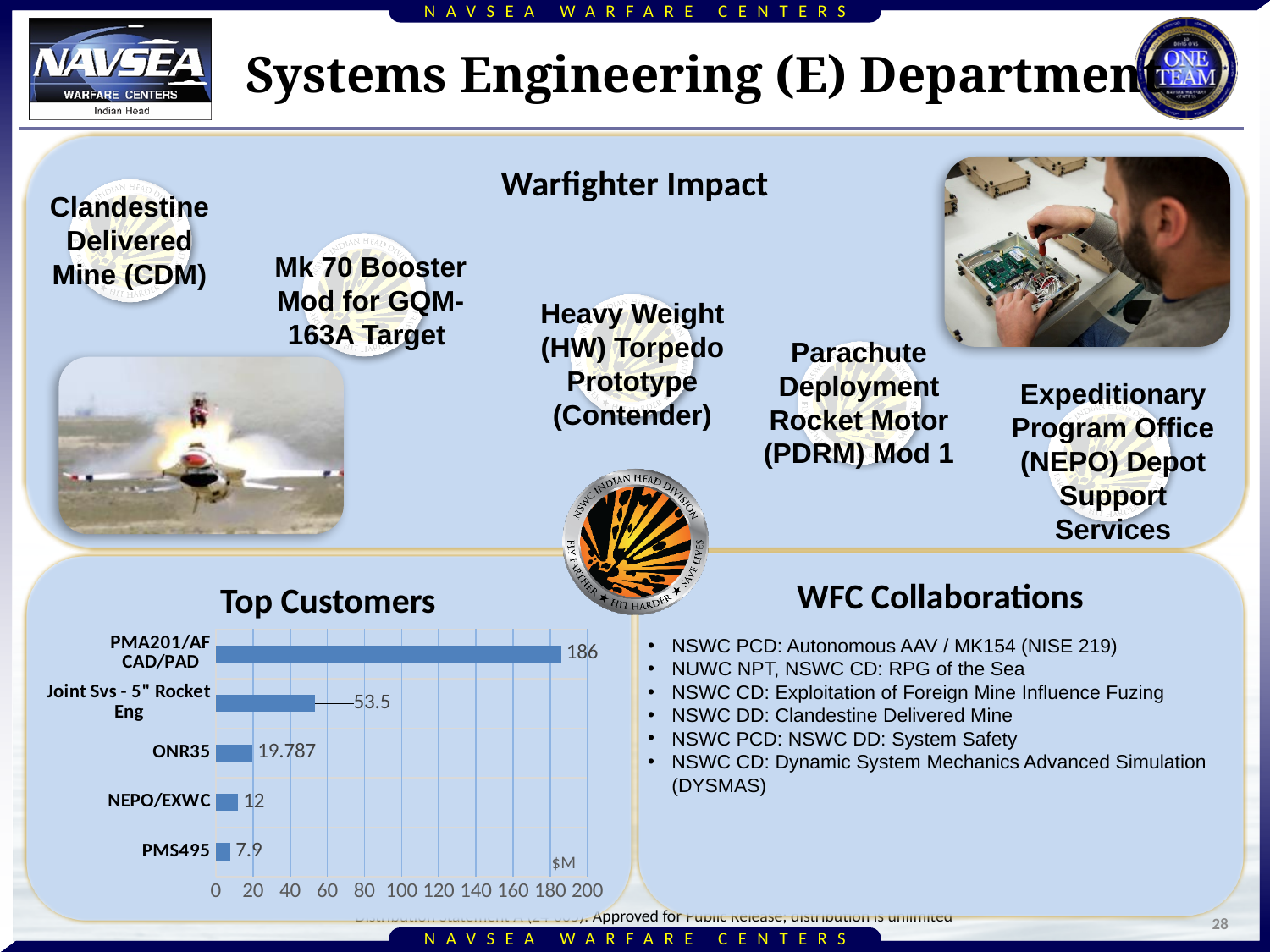
How many customers are shown in the Top Customers chart? 5 What is the value for PMA201/AF CAD/PAD in the Top Customers chart? 186 Which customer has the highest value in the Top Customers chart? PMA201/AF CAD/PAD What is the value for PMS495 in the Top Customers chart? 7.9 What is the value for NEPO/EXWC in the Top Customers chart? 12 In the Top Customers chart, which is larger: the value for NEPO/EXWC or the value for PMS495? NEPO/EXWC What unit label is shown on the axis of the Top Customers chart? $M What kind of chart is the Top Customers chart? bar chart What is the difference between the values for PMA201/AF CAD/PAD and Joint Svs - 5" Rocket Eng in the Top Customers chart? 132.5 Which customer has the lowest value in the Top Customers chart? PMS495 What is the value for ONR35 in the Top Customers chart? 19.787 What is the value for Joint Svs - 5" Rocket Eng in the Top Customers chart? 53.5